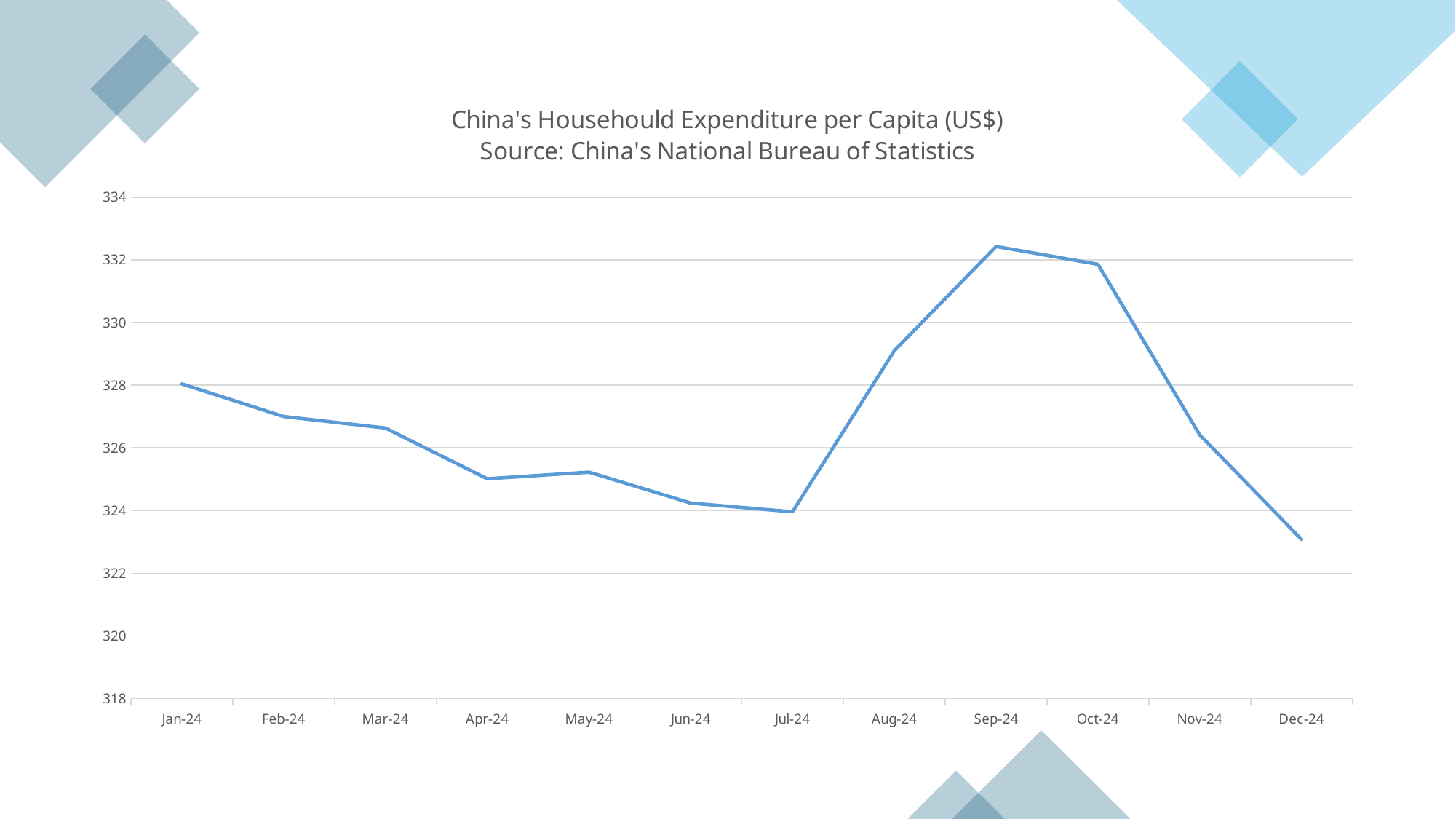
Which month has the lowest household expenditure per capita? Dec-24 Is the value for Dec-24 greater or less than 324? less Which month has the highest household expenditure per capita? Sep-24 Is the value for Sep-24 greater or less than 330? greater Which is larger, the value for Feb-24 or the value for Jun-24? Feb-24 Do the values rise or fall from Jul-24 to Sep-24? rise Is the value for Aug-24 greater or less than 328? greater How many months are plotted on the x axis? 12 What kind of chart is shown on the slide? Line chart According to the chart title, what is the source of the data? China's National Bureau of Statistics Do the values rise or fall from Jan-24 to Jul-24? fall